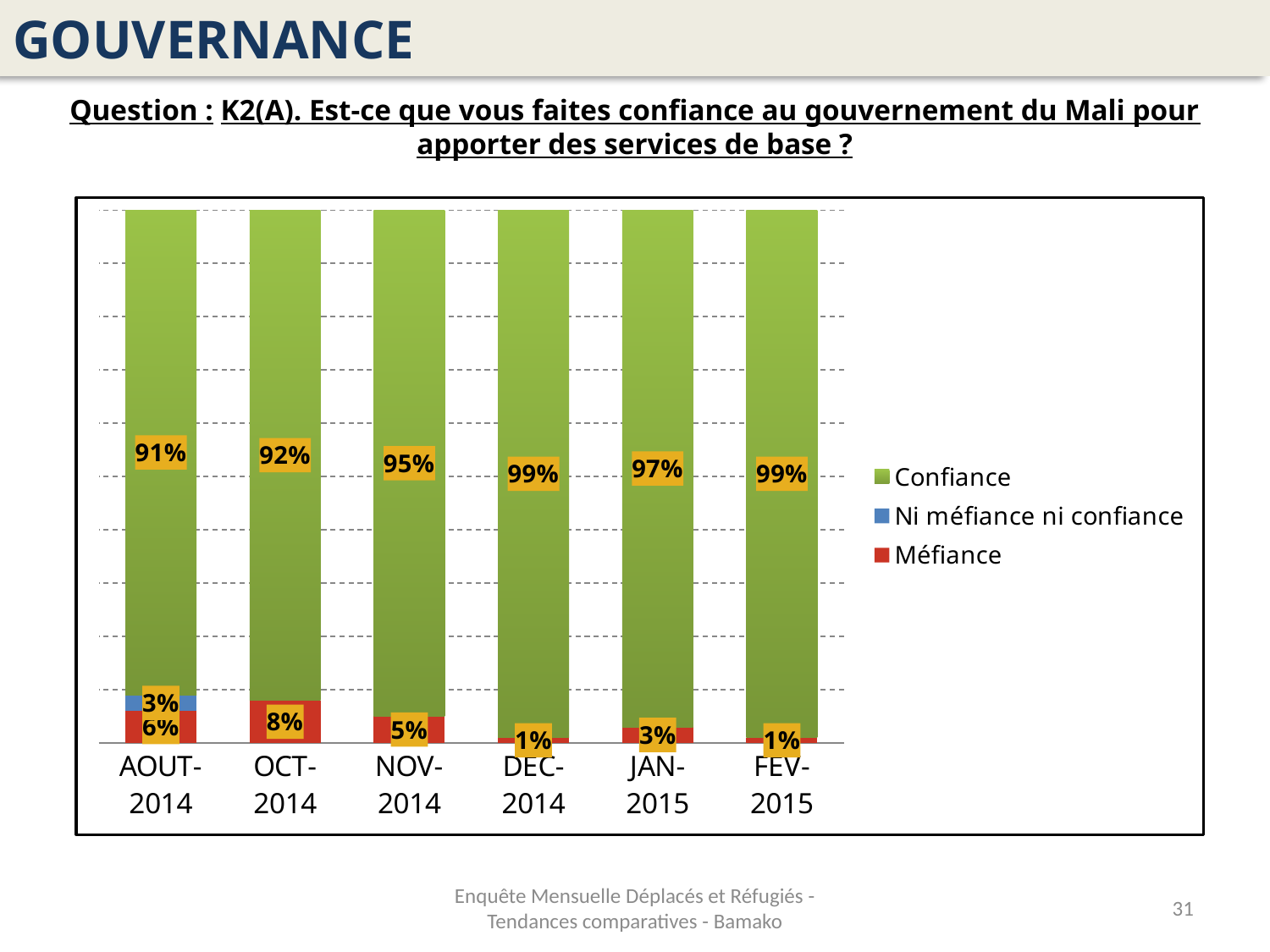
What is the difference between the Méfiance values for OCT-2014 and NOV-2014? 3 percentage points What is the value for Ni méfiance ni confiance in AOUT-2014? 3% What is the total of the stacked bar for AOUT-2014? 100% Is the Confiance value higher in JAN-2015 or in NOV-2014? JAN-2015 What is the Confiance value for NOV-2014? 95% What is the Méfiance value for JAN-2015? 3% What kind of chart is shown on the slide? Stacked bar chart Which month has the highest Méfiance value? OCT-2014 How many series does the legend list? 3 What is the Méfiance value for OCT-2014? 8% How many months are shown on the x axis? 6 Which month has the lowest Confiance value? AOUT-2014